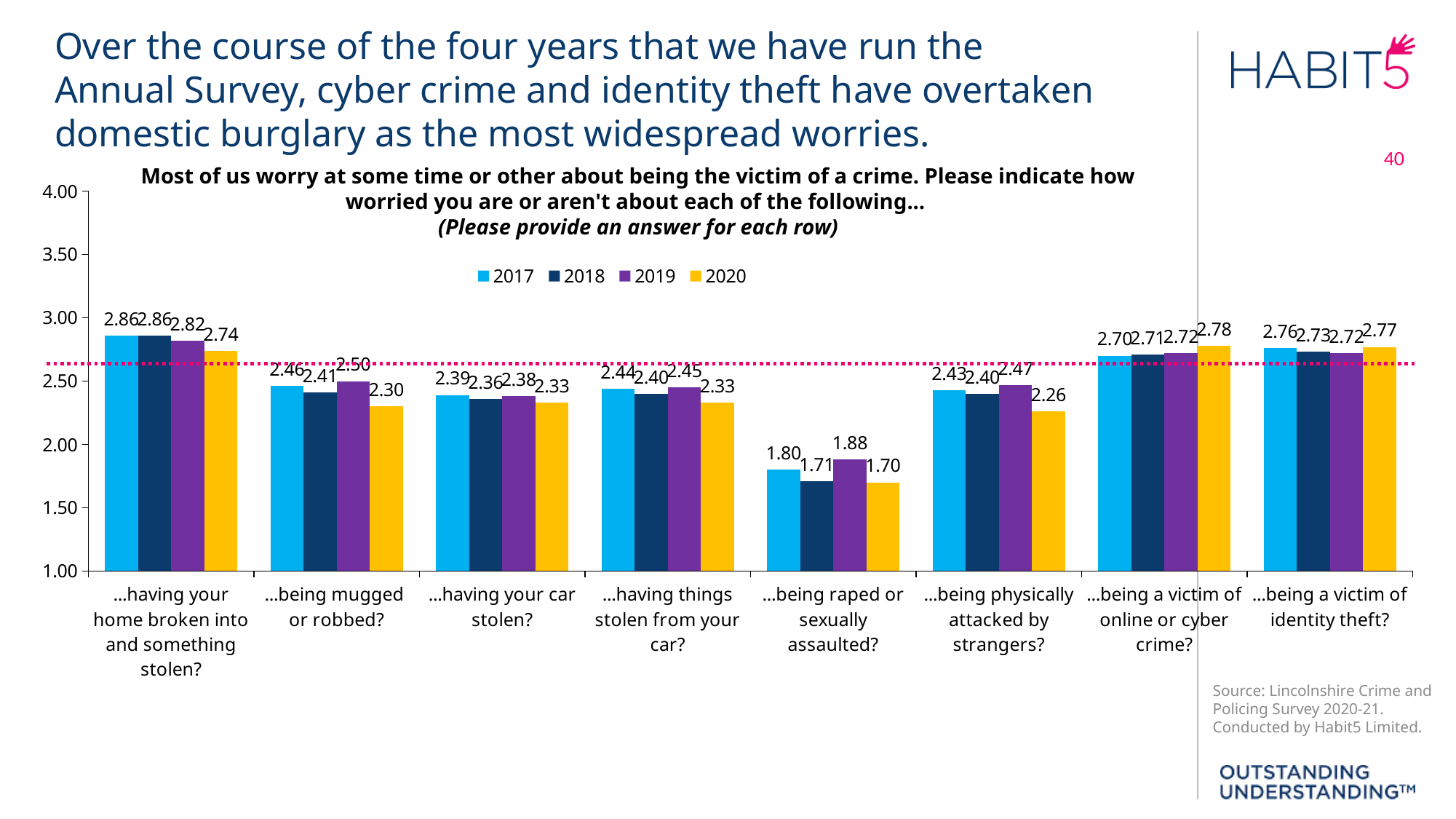
Which category has the lowest 2020 value? ...being raped or sexually assaulted? Which category has the highest 2020 value? ...being a victim of online or cyber crime? What is the 2020 value for "...being a victim of online or cyber crime?" 2.78 How many categories are shown on the x axis? 8 What is the difference between the 2017 and 2020 values for "...having your home broken into and something stolen?" 0.12 What is the 2017 value for "...having your home broken into and something stolen?" 2.86 What kind of chart is shown on the slide? bar chart Which is larger for "...being mugged or robbed?": the 2019 value or the 2020 value? 2019 Is the 2018 value for "...being raped or sexually assaulted?" greater or less than 2.00? less What is the 2020 value for "...being physically attacked by strangers?" 2.26 What is the 2019 value for "...being raped or sexually assaulted?" 1.88 How many series does the legend list? 4